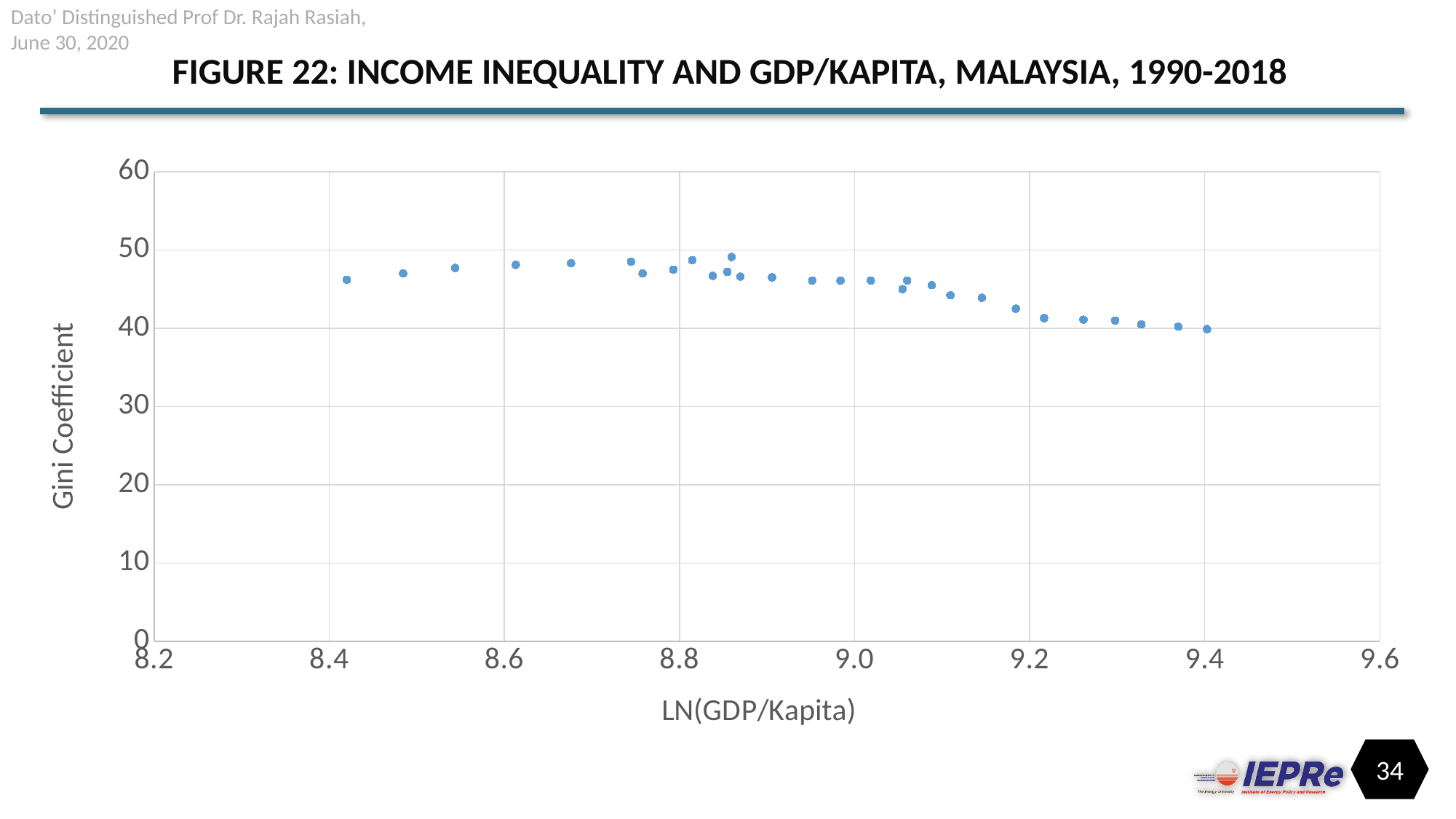
What is the label of the x axis? LN(GDP/Kapita) Is the Gini coefficient of the point near LN(GDP/Kapita) 8.6 greater or less than 45? greater What is the title of the chart? FIGURE 22: INCOME INEQUALITY AND GDP/KAPITA, MALAYSIA, 1990-2018 Overall, do the Gini coefficient values rise or fall as LN(GDP/Kapita) increases? Fall Are any of the plotted Gini coefficient values below 30? No Is the Gini coefficient of the point near LN(GDP/Kapita) 9.2 greater or less than 45? less Is the Gini coefficient higher at the leftmost point (near 8.4) or at the rightmost point (near 9.4)? Leftmost point (near 8.4) What kind of chart is shown on the slide? Scatter chart How many data points are plotted on the chart? 29